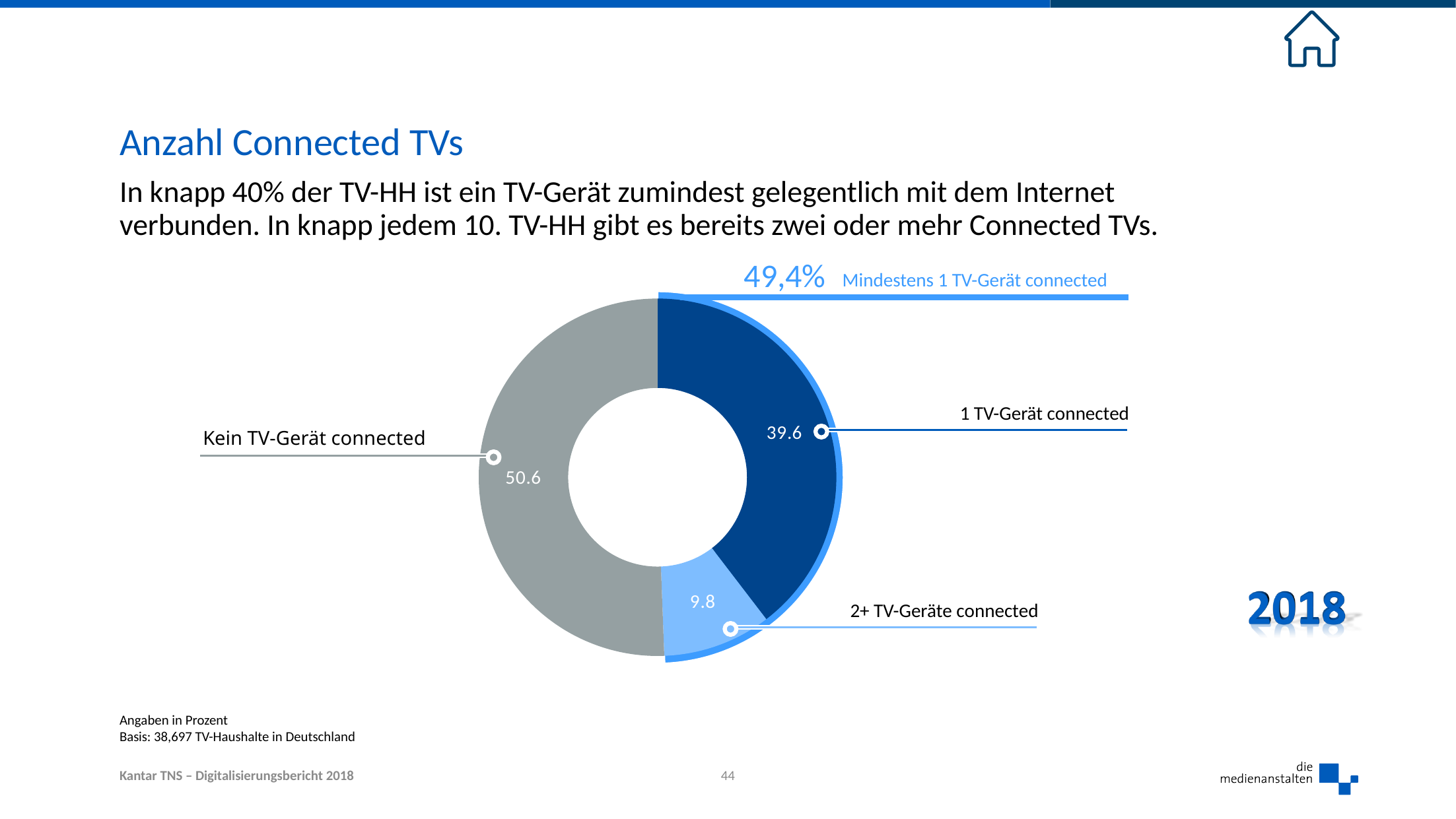
Which category has the smallest slice? 2+ TV-Geräte connected What percentage is given on the slide for "Mindestens 1 TV-Gerät connected"? 49,4% What kind of chart is shown on the slide? Donut (pie) chart What is the difference between the values for "1 TV-Gerät connected" and "2+ TV-Geräte connected"? 29.8 What is the value for "Kein TV-Gerät connected"? 50.6 What is the value for "2+ TV-Geräte connected"? 9.8 What is the value for "1 TV-Gerät connected"? 39.6 How many categories does the chart show? 3 What is the difference between the values for "Kein TV-Gerät connected" and "1 TV-Gerät connected"? 11.0 Which category has the largest slice? Kein TV-Gerät connected Which is larger: the value for "1 TV-Gerät connected" or for "2+ TV-Geräte connected"? 1 TV-Gerät connected What is the title of the chart on the slide? Anzahl Connected TVs